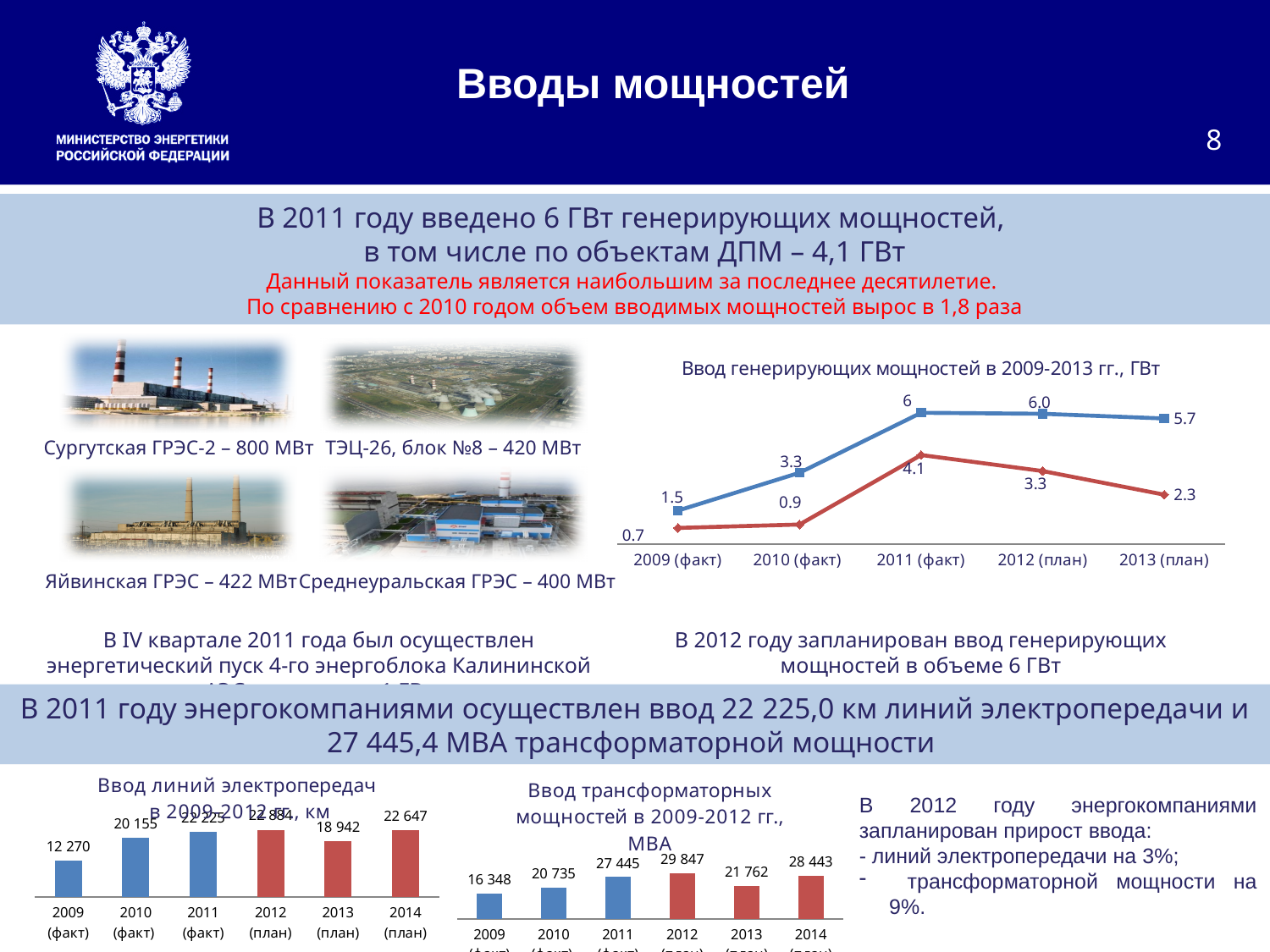
On the line chart 'Ввод генерирующих мощностей в 2009-2013 гг., ГВт', what is the value of the blue line for 2013 (план)? 5.7 On the bar chart 'Ввод трансформаторных мощностей в 2009-2012 гг., МВА', which is larger: the value for 2011 (факт) or 2014 (план)? 2014 (план) On the line chart 'Ввод генерирующих мощностей в 2009-2013 гг., ГВт', what is the value of the red line for 2011 (факт)? 4.1 On the bar chart 'Ввод трансформаторных мощностей в 2009-2012 гг., МВА', what is the value for 2013 (план)? 21 762 On the line chart 'Ввод генерирующих мощностей в 2009-2013 гг., ГВт', what is the difference between the blue and red values for 2010 (факт)? 2.4 On the bar chart 'Ввод линий электропередач в 2009-2012 гг., км', which year has the lowest value? 2009 (факт) On the bar chart 'Ввод линий электропередач в 2009-2012 гг., км', what is the value for 2011 (факт)? 22 225 On the line chart 'Ввод генерирующих мощностей в 2009-2013 гг., ГВт', how many points are plotted along the x axis for each line? 5 What kind of chart is 'Ввод линий электропередач в 2009-2012 гг., км'? bar chart On the bar chart 'Ввод трансформаторных мощностей в 2009-2012 гг., МВА', which year has the highest value? 2012 (план) On the line chart 'Ввод генерирующих мощностей в 2009-2013 гг., ГВт', does the red line rise or fall from 2011 (факт) to 2013 (план)? fall On the line chart 'Ввод генерирующих мощностей в 2009-2013 гг., ГВт', what is the value of the red line for 2009 (факт)? 0.7